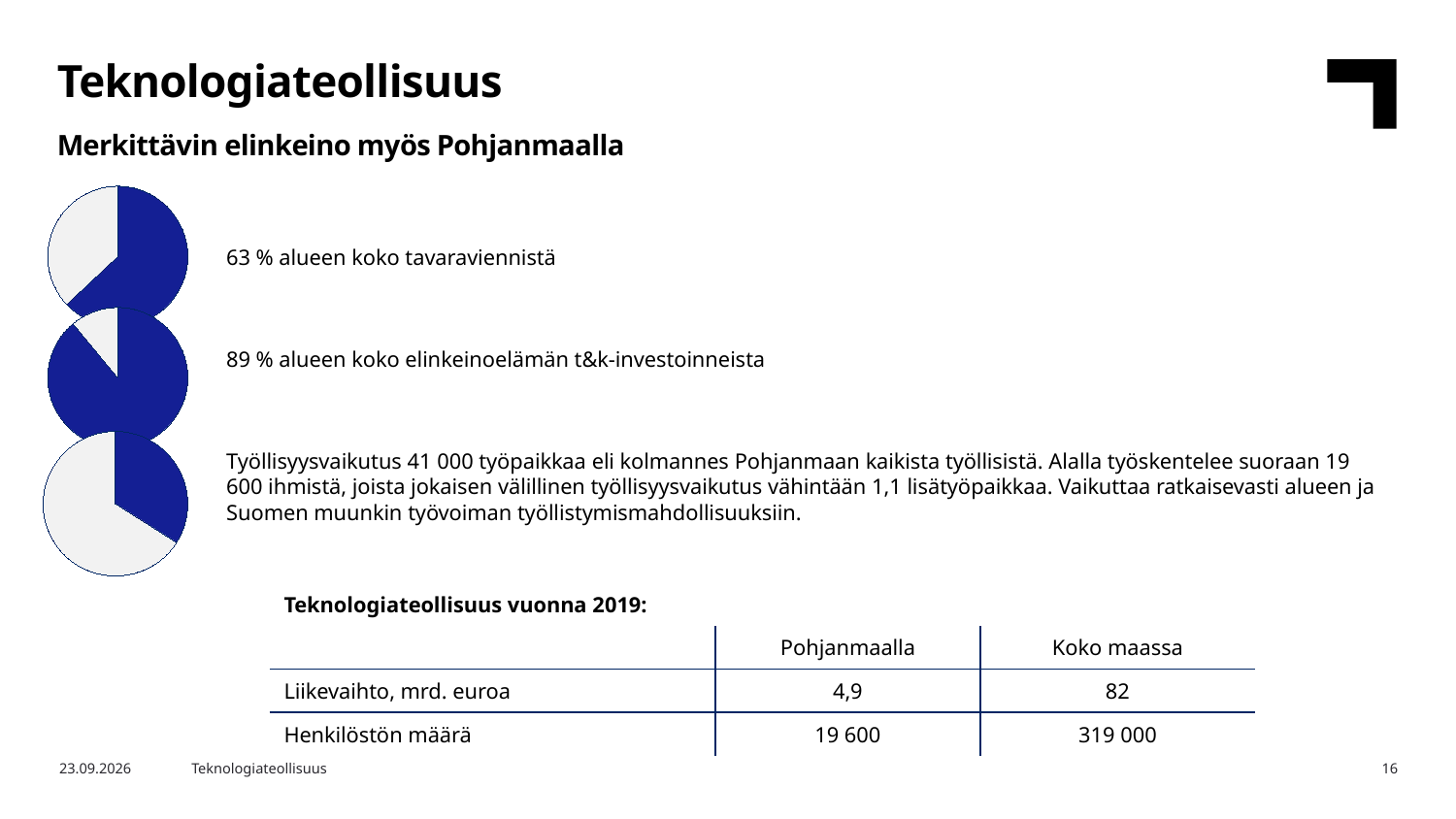
What kind of charts are shown on the left side of the slide? Pie charts Which of the three pie charts has the smallest blue slice? The bottom one What is the title of the slide containing the pie charts? Teknologiateollisuus Is the blue slice in the middle pie chart more or less than half of the pie? more Is the blue slice in the top pie chart larger or smaller than the blue slice in the middle pie chart? smaller How many pie charts are on the slide? 3 According to the text next to the middle pie chart, what share of the region's business R&D investments does the technology industry account for? 89 % What is the difference in percentage points between the shares shown for the middle pie chart (89 %) and the top pie chart (63 %)? 26 percentage points According to the text next to the top pie chart, what share of the region's total goods exports does the technology industry account for? 63 % What colour is used for the highlighted slice in the pie charts? Blue Which of the three pie charts has the largest blue slice? The middle one (89 %) Is the blue slice in the bottom pie chart more or less than half of the pie? less